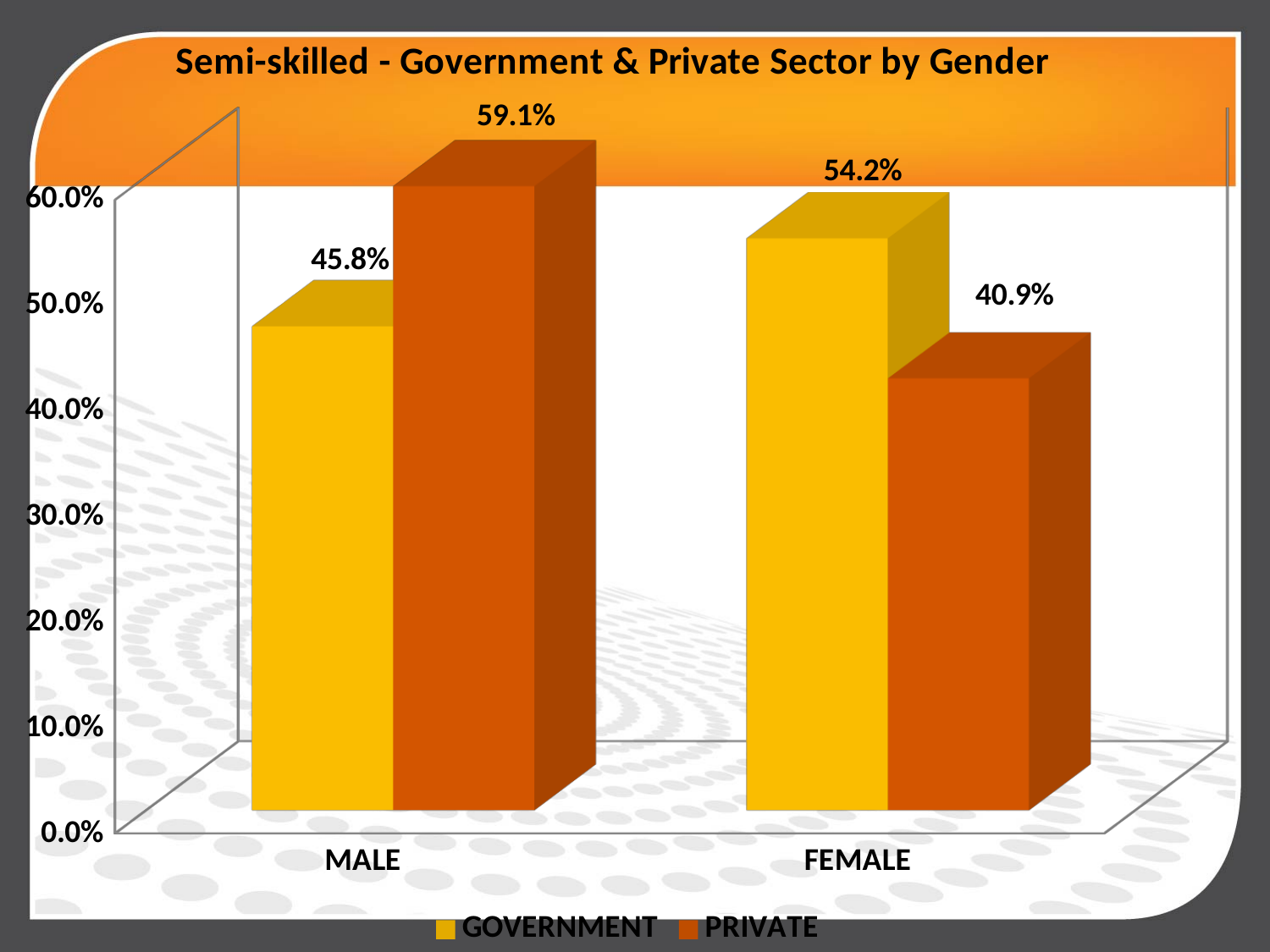
What kind of chart is shown on the slide? Bar chart What is the GOVERNMENT value for FEMALE? 54.2% What is the difference between the GOVERNMENT and PRIVATE values for FEMALE? 13.3% Which gender has the lower GOVERNMENT value? MALE For FEMALE, is the GOVERNMENT or PRIVATE value larger? GOVERNMENT Which gender has the higher PRIVATE value? MALE What is the PRIVATE value for MALE? 59.1% What is the PRIVATE value for FEMALE? 40.9% How many categories are shown on the x axis? 2 What is the GOVERNMENT value for MALE? 45.8% How many series does the legend list? 2 What is the difference between the PRIVATE and GOVERNMENT values for MALE? 13.3%